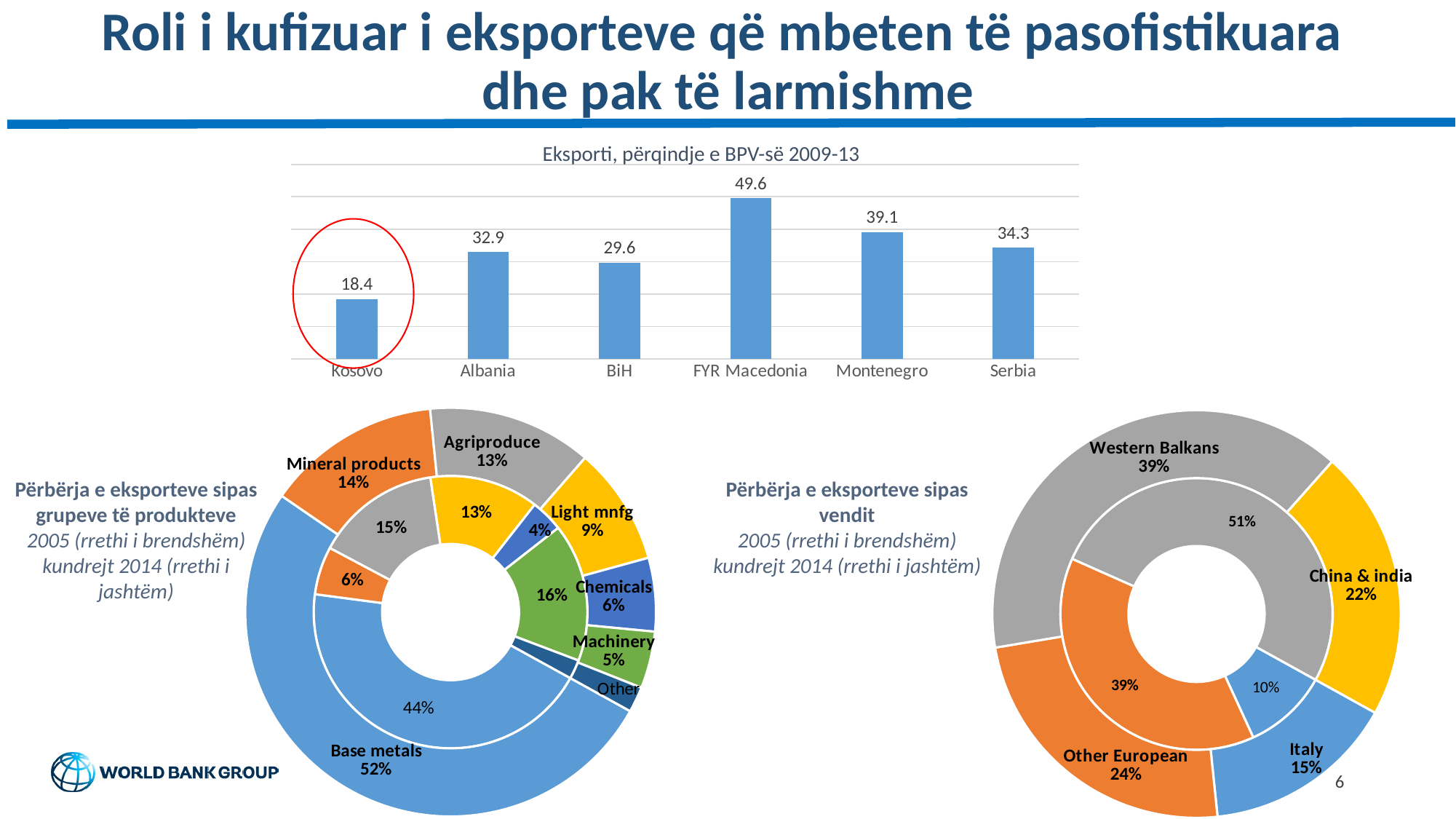
In the bar chart 'Eksporti, përqindje e BPV-së 2009-13', which is larger, the value for Montenegro or the value for Serbia? Montenegro What kind of chart is the chart titled 'Eksporti, përqindje e BPV-së 2009-13'? bar chart In the bar chart 'Eksporti, përqindje e BPV-së 2009-13', which country has the lowest value? Kosovo In the doughnut chart on the bottom right (exports by country), what is the difference between the outer-ring shares of Other European and Italy? 9% In the bar chart 'Eksporti, përqindje e BPV-së 2009-13', which country's bar is circled in red? Kosovo In the doughnut chart on the bottom right (exports by country), what is the share of Western Balkans in the outer ring (2014)? 39% In the doughnut chart on the bottom left (exports by product group), what is the share of Chemicals in the outer ring (2014)? 6% How many countries are shown in the bar chart 'Eksporti, përqindje e BPV-së 2009-13'? 6 In the bar chart 'Eksporti, përqindje e BPV-së 2009-13', which country has the highest value? FYR Macedonia In the bar chart 'Eksporti, përqindje e BPV-së 2009-13', what is the difference between the values for FYR Macedonia and Kosovo? 31.2 In the doughnut chart on the bottom left (exports by product group), what is the share of Base metals in the outer ring (2014)? 52% In the bar chart 'Eksporti, përqindje e BPV-së 2009-13', what is the value for Kosovo? 18.4